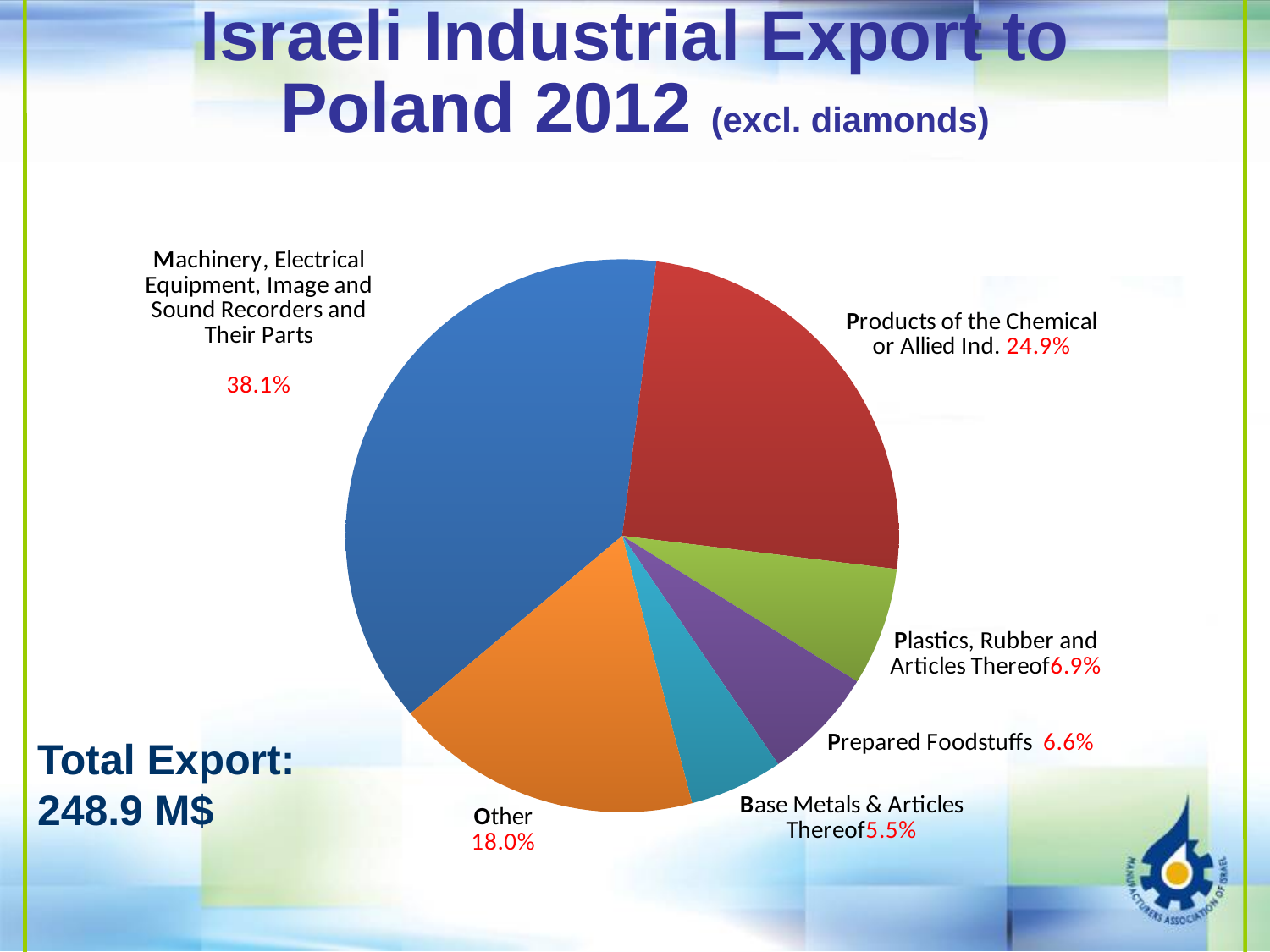
What share of Israeli industrial export to Poland in 2012 is Machinery, Electrical Equipment, Image and Sound Recorders and Their Parts? 38.1% Which category has the smallest share of the pie? Base Metals & Articles Thereof Which is larger: the share for Other or the share for Plastics, Rubber and Articles Thereof? Other How many percentage points larger is the Machinery share than the Products of the Chemical or Allied Ind. share? 13.2 What share does the Other slice represent? 18.0% How many slices does the pie chart have? 6 What percentage of the pie is Products of the Chemical or Allied Ind.? 24.9% What is the difference in percentage points between Products of the Chemical or Allied Ind. and Other? 6.9 What total export value is stated on the slide? 248.9 M$ Which category has the largest share of the pie? Machinery, Electrical Equipment, Image and Sound Recorders and Their Parts What type of chart is shown on the slide? Pie chart What percentage is shown for Base Metals & Articles Thereof? 5.5%